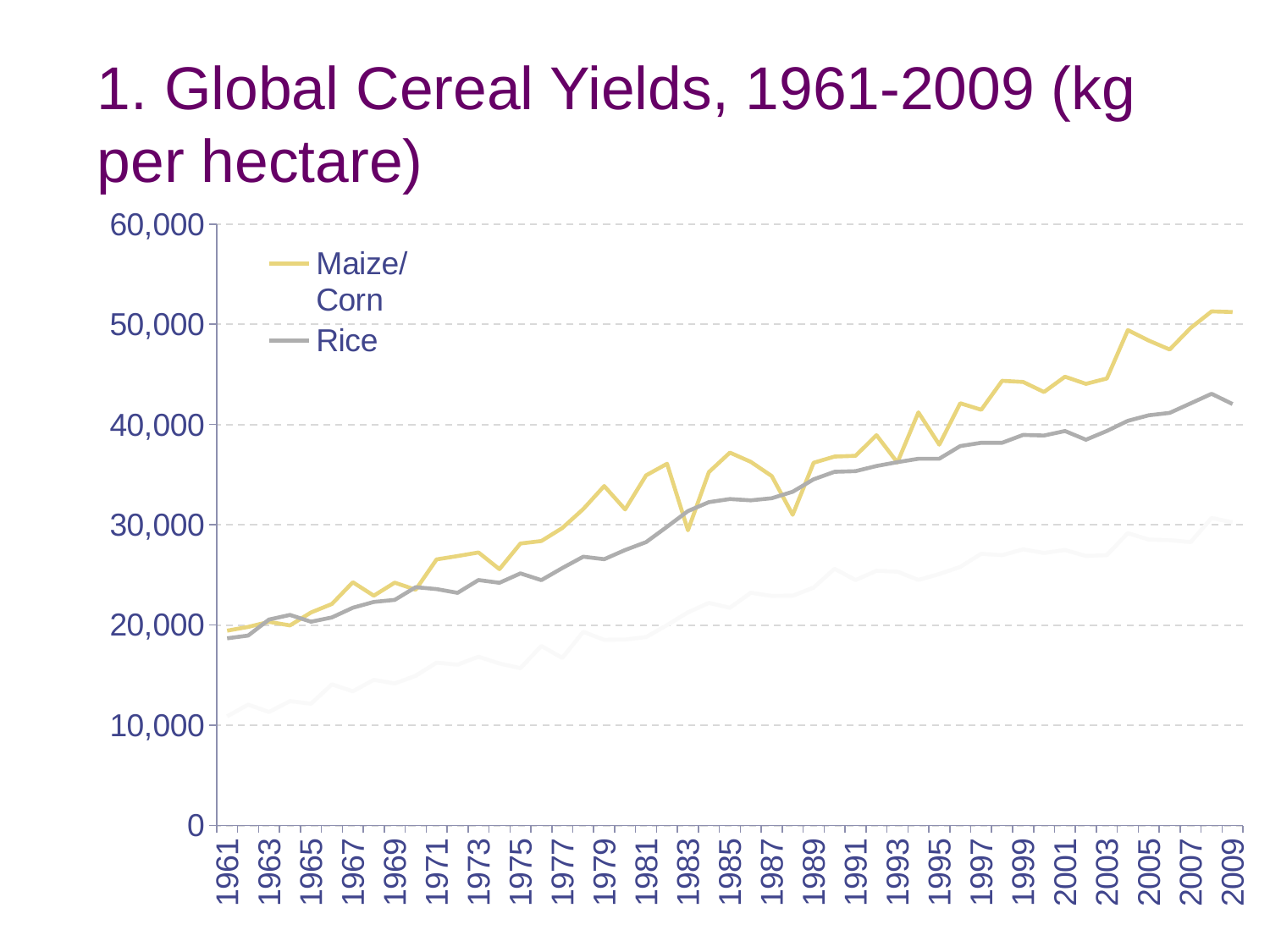
Does the Maize/Corn yield generally rise or fall from 1961 to 2009? rise What kind of chart is shown on the slide? line chart In 2009, which series has the higher value, Maize/Corn or Rice? Maize/Corn Does the Rice yield generally rise or fall from 1961 to 2009? rise How many series does the legend list? 2 What colour is the Maize/Corn line? yellow Is the Rice value for 1961 greater or less than 20,000? less What is the title of the chart? 1. Global Cereal Yields, 1961-2009 (kg per hectare) Is the Maize/Corn value for 1985 greater or less than 30,000? greater In 1983, which series has the higher value, Maize/Corn or Rice? Rice Is the Maize/Corn value for 2009 greater or less than 50,000? greater